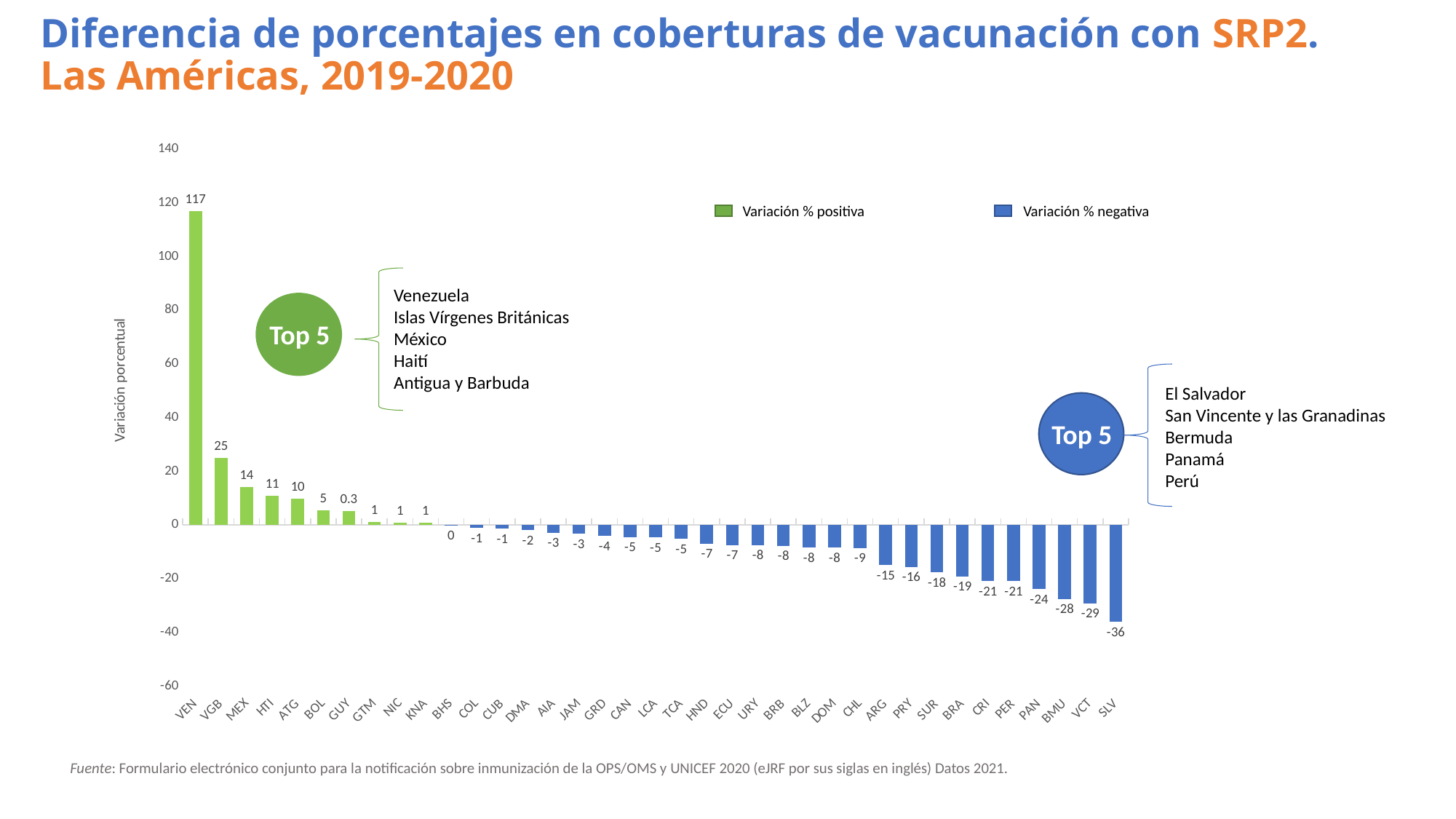
What is the value for PAN? -24 What is the value for SLV? -36 Which category has the highest value? VEN Which is larger, the value for BMU or the value for VCT? BMU How many categories are shown on the x axis? 37 What is the value for VEN? 117 What is the difference between the values for VEN and VGB? 92 How many series does the legend list? 2 What is the value for MEX? 14 Which category has the lowest value? SLV What kind of chart is shown on the slide? Bar chart What is the label of the y axis? Variación porcentual